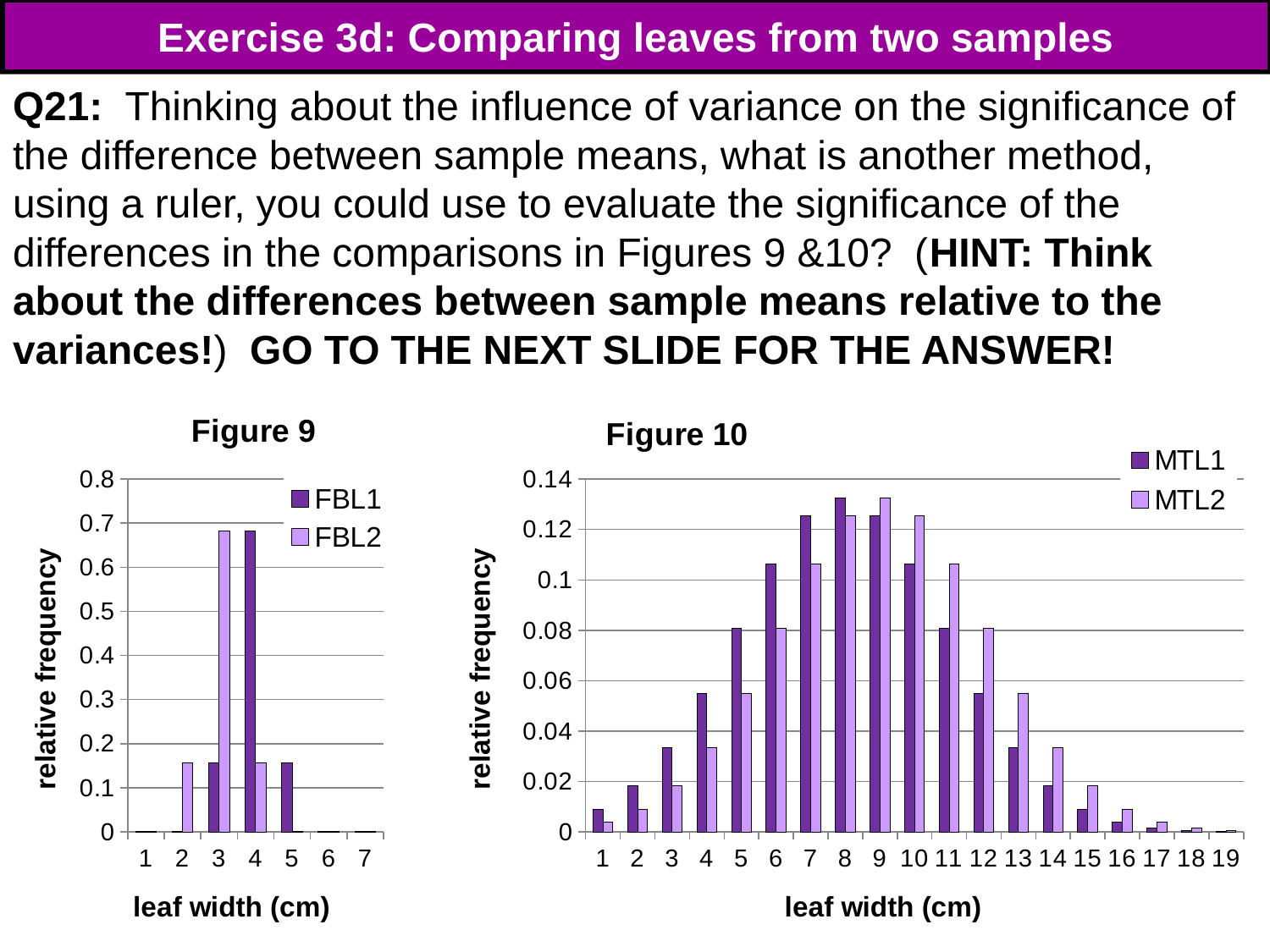
In Figure 9, is the FBL2 value at leaf width 2 greater or less than 0.2? less In Figure 10, which leaf width has the highest relative frequency for MTL1? 8 In Figure 10, is the MTL1 value at leaf width 7 greater or less than 0.12? greater What kind of chart is Figure 9? bar chart How many leaf width categories are shown on the x axis of Figure 10? 19 In Figure 9, which leaf width has the highest relative frequency for FBL2? 3 In Figure 10, which leaf width has the highest relative frequency for MTL2? 9 In Figure 9, is the FBL1 value at leaf width 4 greater or less than 0.6? greater How many series does the legend of Figure 9 list? 2 In Figure 10, at leaf width 4, which series has the larger value, MTL1 or MTL2? MTL1 How many leaf width categories are shown on the x axis of Figure 9? 7